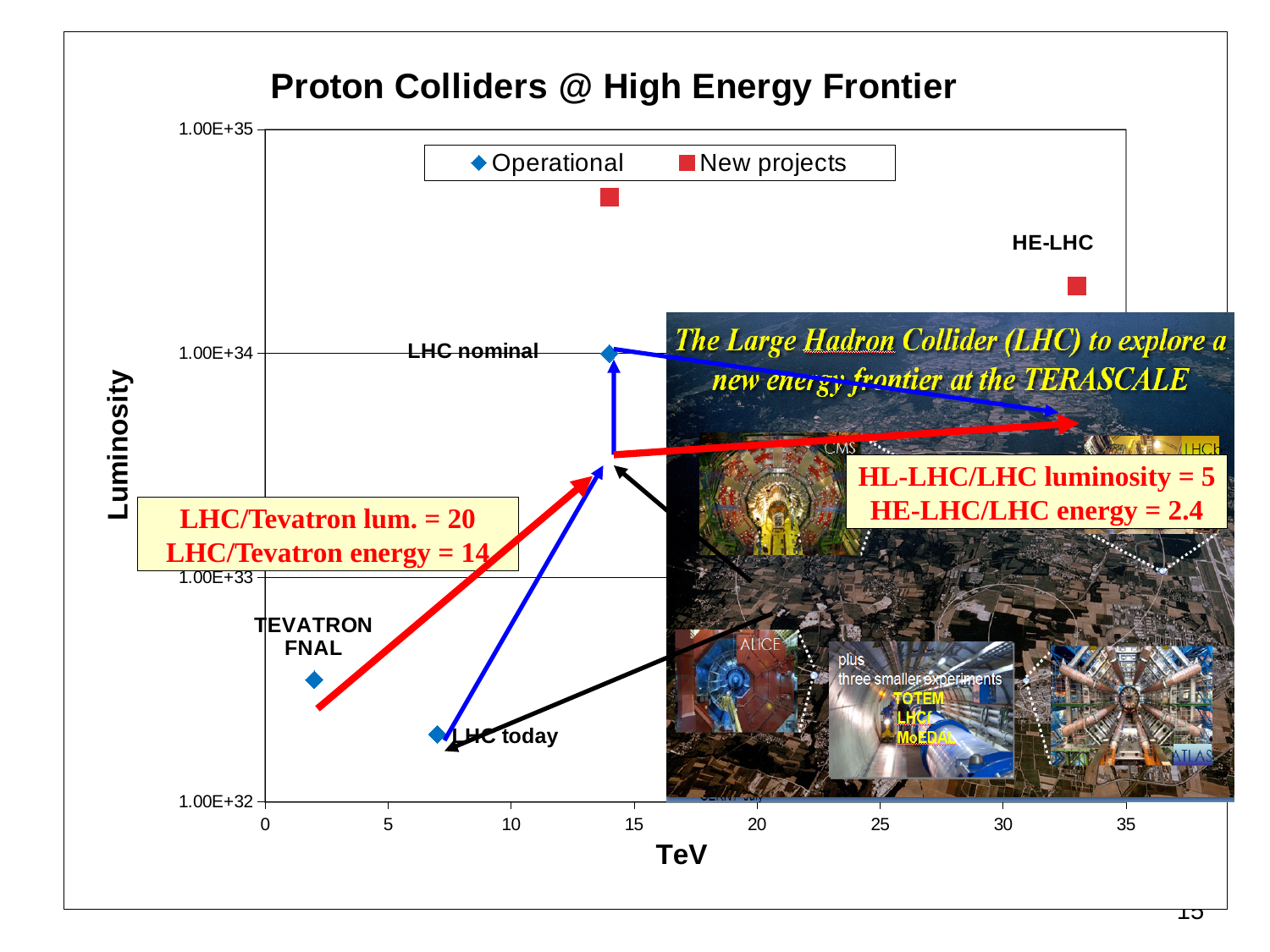
How many data points are plotted on the chart? 5 What kind of chart is shown on the slide? scatter chart Which labeled point has the lowest luminosity on the chart? LHC today Is the energy of HE-LHC greater or less than 30 TeV? greater How many series does the chart legend list? 2 What luminosity value does the LHC nominal point sit on? 1.00E+34 Which labeled collider has the lowest energy (TeV) on the chart? TEVATRON FNAL Is the luminosity of TEVATRON FNAL greater or less than 1.00E+33? less Which labeled collider has the highest energy (TeV) on the chart? HE-LHC What is the title of the chart's x axis? TeV Which has the higher energy, HE-LHC or LHC nominal? HE-LHC What are the two series named in the chart legend? Operational and New projects